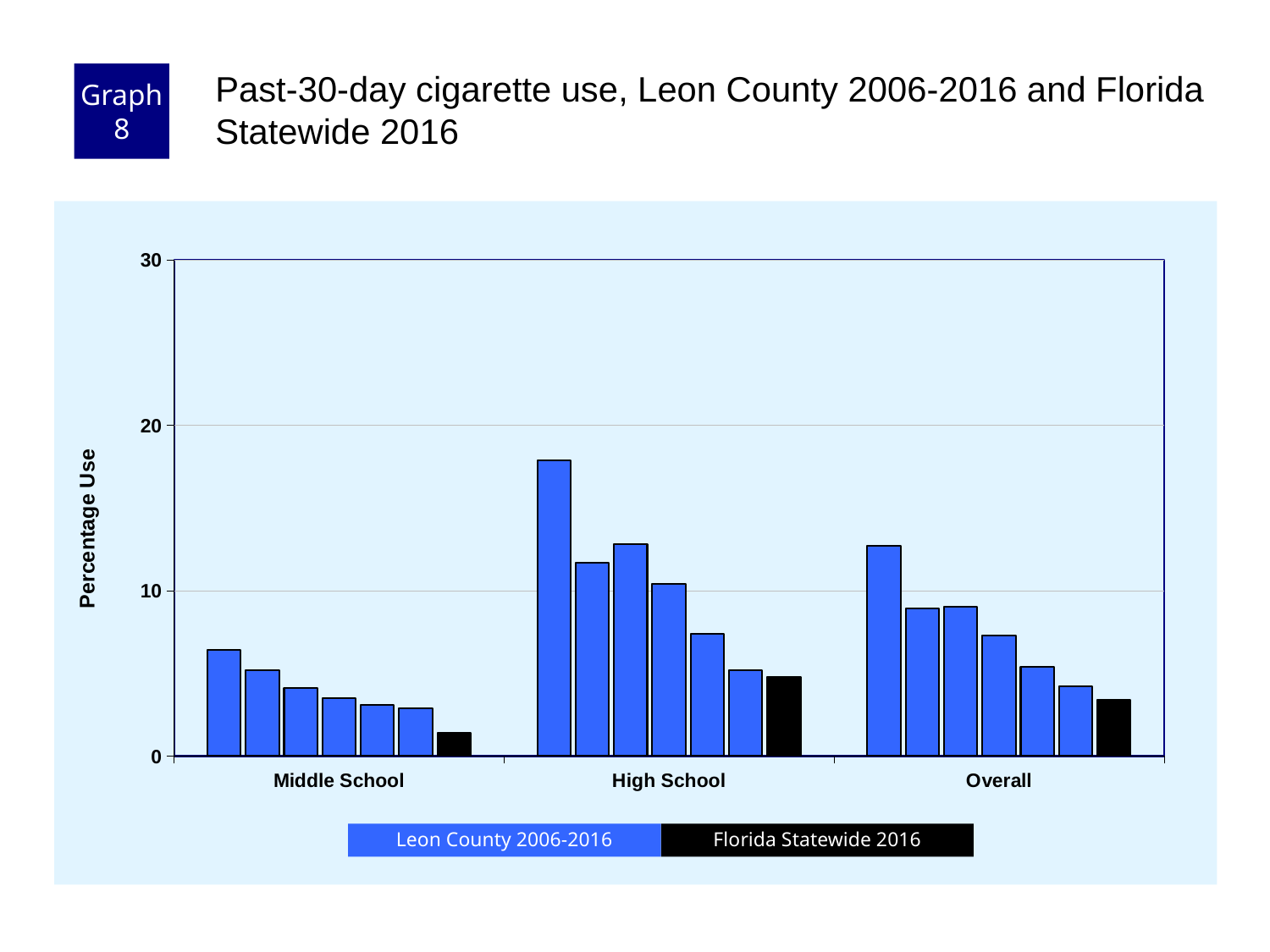
Is the Florida Statewide 2016 value for Middle School greater or less than 10? less Which is larger, the Florida Statewide 2016 bar for High School or the Florida Statewide 2016 bar for Middle School? High School Is the first Leon County bar for Overall greater or less than 10? greater What colour are the Florida Statewide 2016 bars? black How many categories are shown on the x axis? 3 Which category group contains the shortest bar? Middle School What kind of chart is shown on the slide? bar chart Is the tallest Leon County bar for High School greater or less than 10? greater Do the Leon County 2006-2016 bars for Middle School rise or fall from left to right? fall How many series does the legend list? 2 Which category group contains the tallest bar? High School